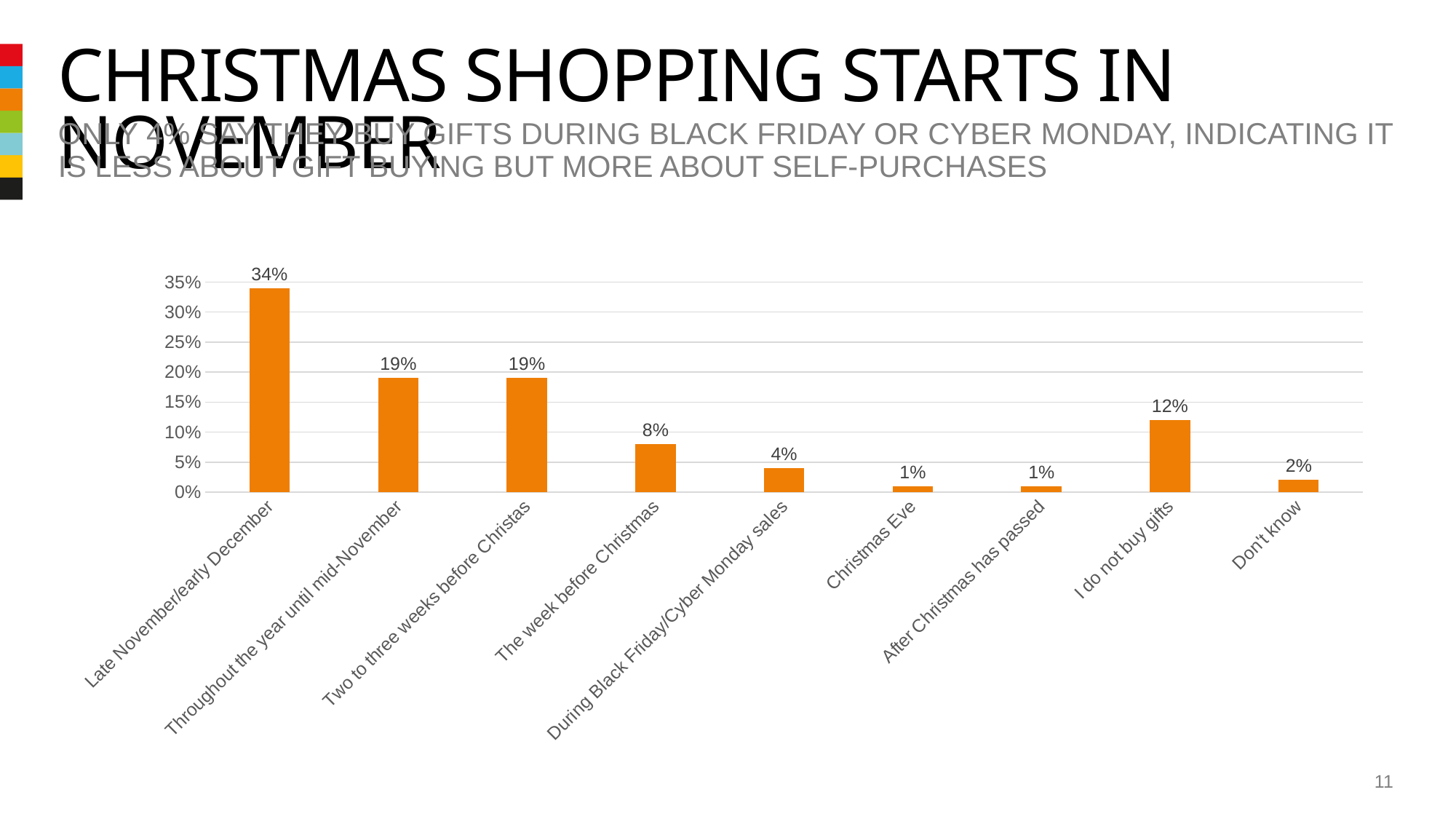
What colour are the bars in the chart? Orange How many categories are shown on the x axis? 9 What is the value for 'I do not buy gifts'? 12% What is the value for 'The week before Christmas'? 8% What is the difference between the values for 'Late November/early December' and 'I do not buy gifts'? 22% What is the value for 'During Black Friday/Cyber Monday sales'? 4% Which category has the highest value? Late November/early December Is the value for 'Throughout the year until mid-November' greater or less than 15%? greater What is the value for 'Christmas Eve'? 1% What percentage of respondents say they buy gifts in late November/early December? 34% What kind of chart is shown on the slide? Bar chart Which is larger: the value for 'The week before Christmas' or the value for 'Don't know'? The week before Christmas